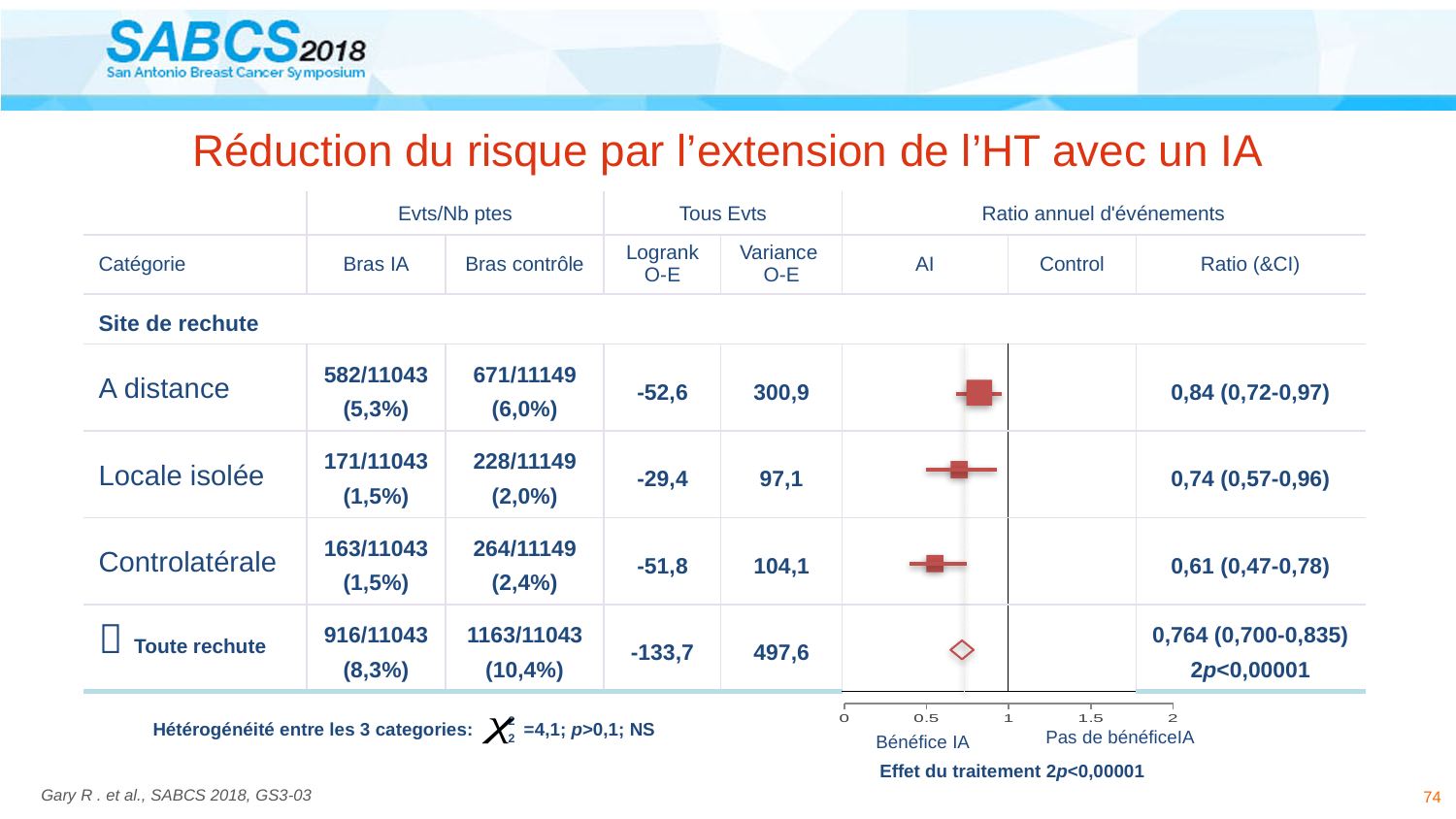
Among the three relapse site categories, which has the highest ratio? A distance What is the overall ratio (with CI) shown for 'Toute rechute' (the diamond in the forest plot)? 0,764 (0,700-0,835) What kind of chart is shown in the 'Ratio annuel d'événements' column? Forest plot How many point estimates (squares and diamond) are plotted in the forest plot? 4 Which has the larger ratio, 'Locale isolée' or 'Controlatérale'? Locale isolée What is the ratio (with CI) plotted for the 'A distance' category in the forest plot? 0,84 (0,72-0,97) What is the difference between the ratio for 'A distance' and the ratio for 'Controlatérale'? 0,23 What is the highest tick value shown on the forest plot's x axis? 2 What is the ratio (with CI) plotted for the 'Controlatérale' category? 0,61 (0,47-0,78) Is the ratio for 'Locale isolée' greater or less than 1 on the forest plot axis? less What label appears under the left side of the forest plot axis (below 0.5)? Bénéfice IA Which relapse site category has the lowest ratio in the forest plot? Controlatérale